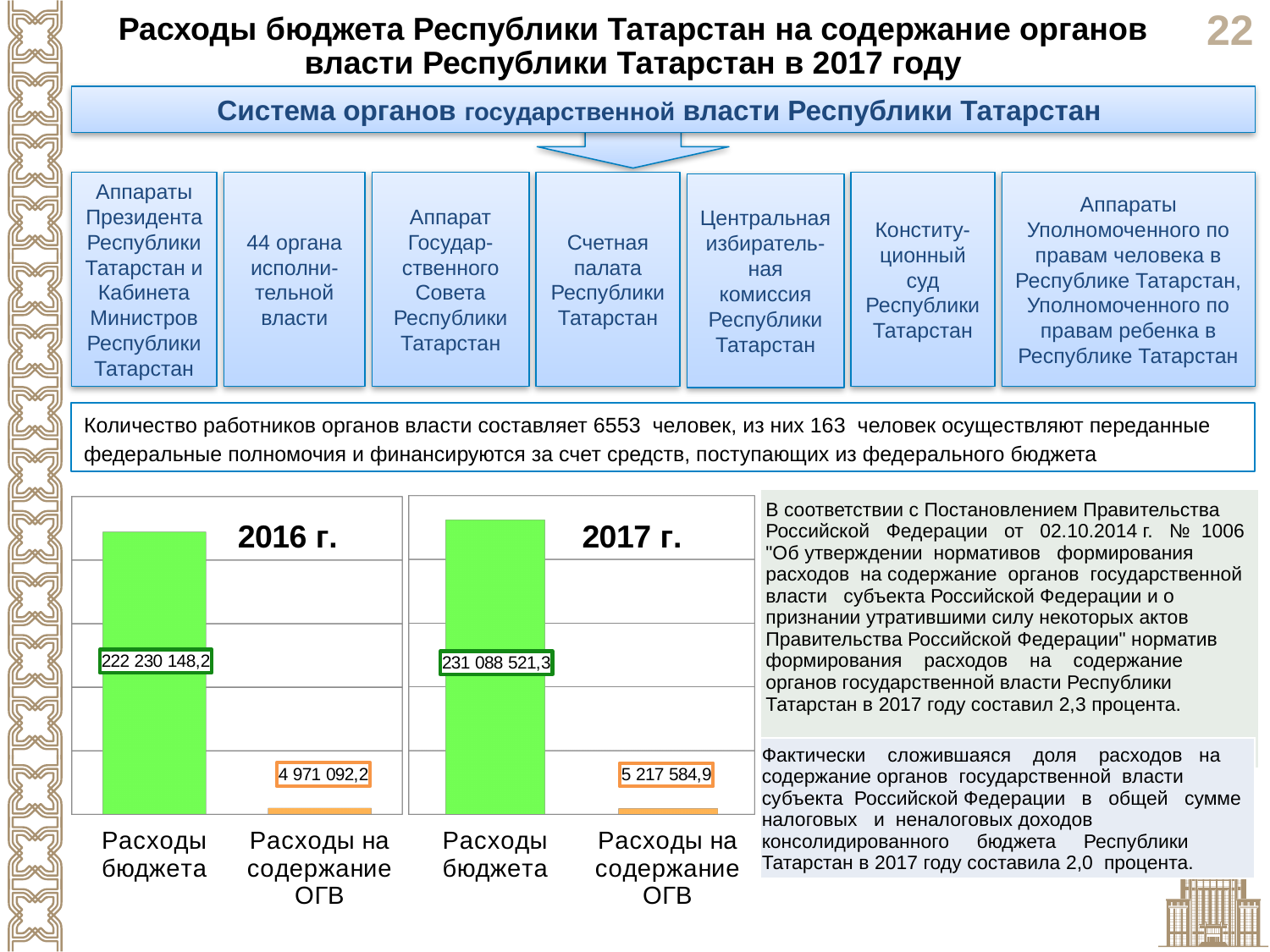
In the 2017 г. chart, what is the value for Расходы на содержание ОГВ? 5 217 584,9 What type of chart is the 2016 г. chart? Bar chart In the 2017 г. chart, which category has the highest value? Расходы бюджета In the 2016 г. chart, which category has the lowest value? Расходы на содержание ОГВ Is Расходы на содержание ОГВ larger in the 2016 г. chart or in the 2017 г. chart? 2017 г. In the 2016 г. chart, what is the value for Расходы бюджета? 222 230 148,2 In the 2017 г. chart, what colour is the bar for Расходы бюджета? Green In the 2016 г. chart, what is the difference between Расходы бюджета and Расходы на содержание ОГВ? 217 259 056,0 In the 2017 г. chart, what is the value for Расходы бюджета? 231 088 521,3 Comparing the two charts, by how much is Расходы бюджета in 2017 г. larger than in 2016 г.? 8 858 373,1 In the 2016 г. chart, what is the value for Расходы на содержание ОГВ? 4 971 092,2 How many categories are shown in the 2017 г. chart? 2